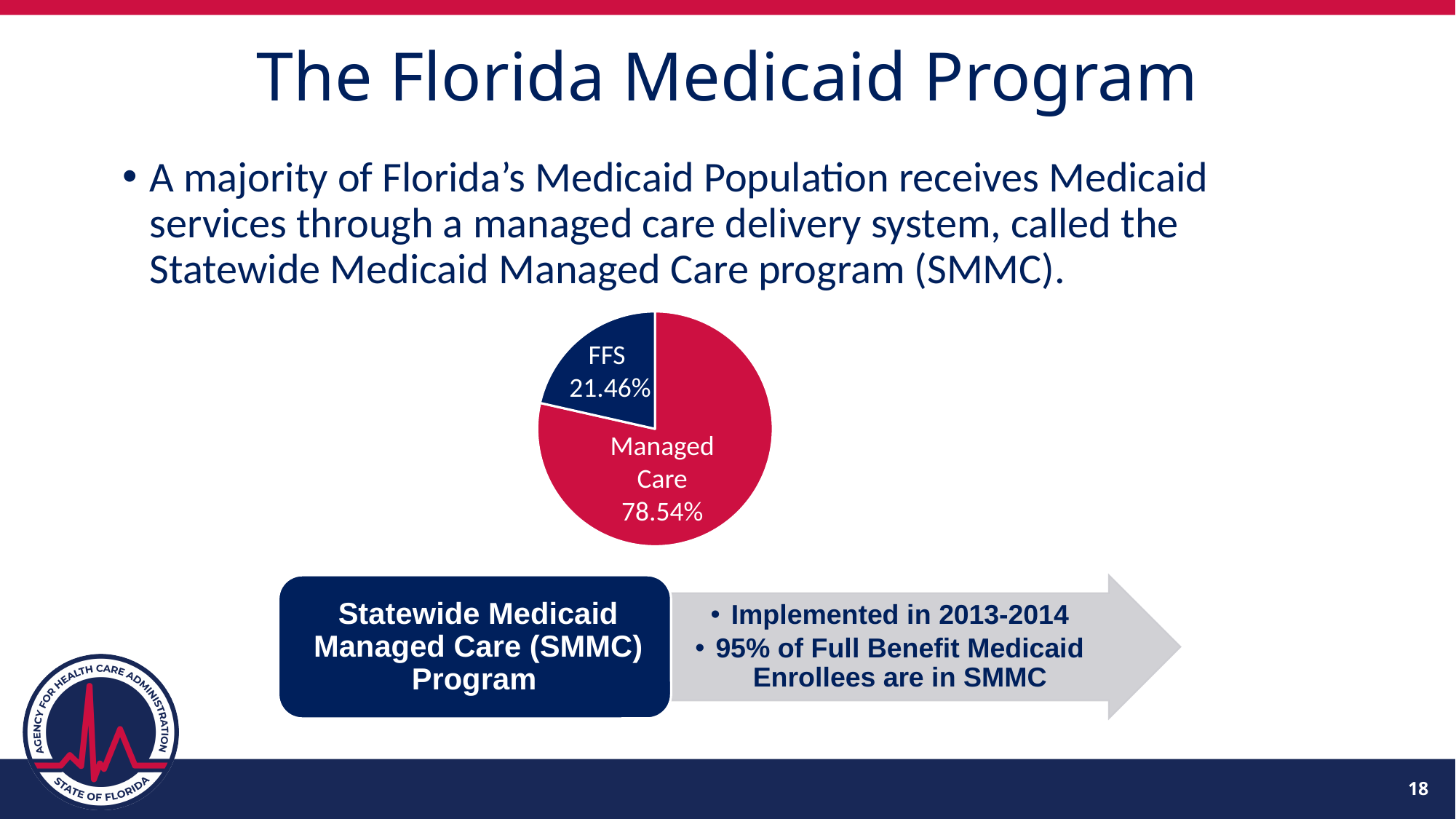
What is the difference in percentage points between the Managed Care and FFS slices? 57.08 What share of the pie chart is labelled Managed Care? 78.54% Which slice of the pie chart is the largest? Managed Care What colour is the Managed Care slice of the pie chart? Red What kind of chart is shown on the slide? Pie chart Is the FFS share of the pie chart greater or less than 25%? less Is the Managed Care share of the pie chart greater or less than 75%? greater How many slices does the pie chart have? 2 Which slice of the pie chart is the smallest? FFS What share of the pie chart is labelled FFS? 21.46% Which is larger in the pie chart, FFS or Managed Care? Managed Care What colour is the FFS slice of the pie chart? Dark blue